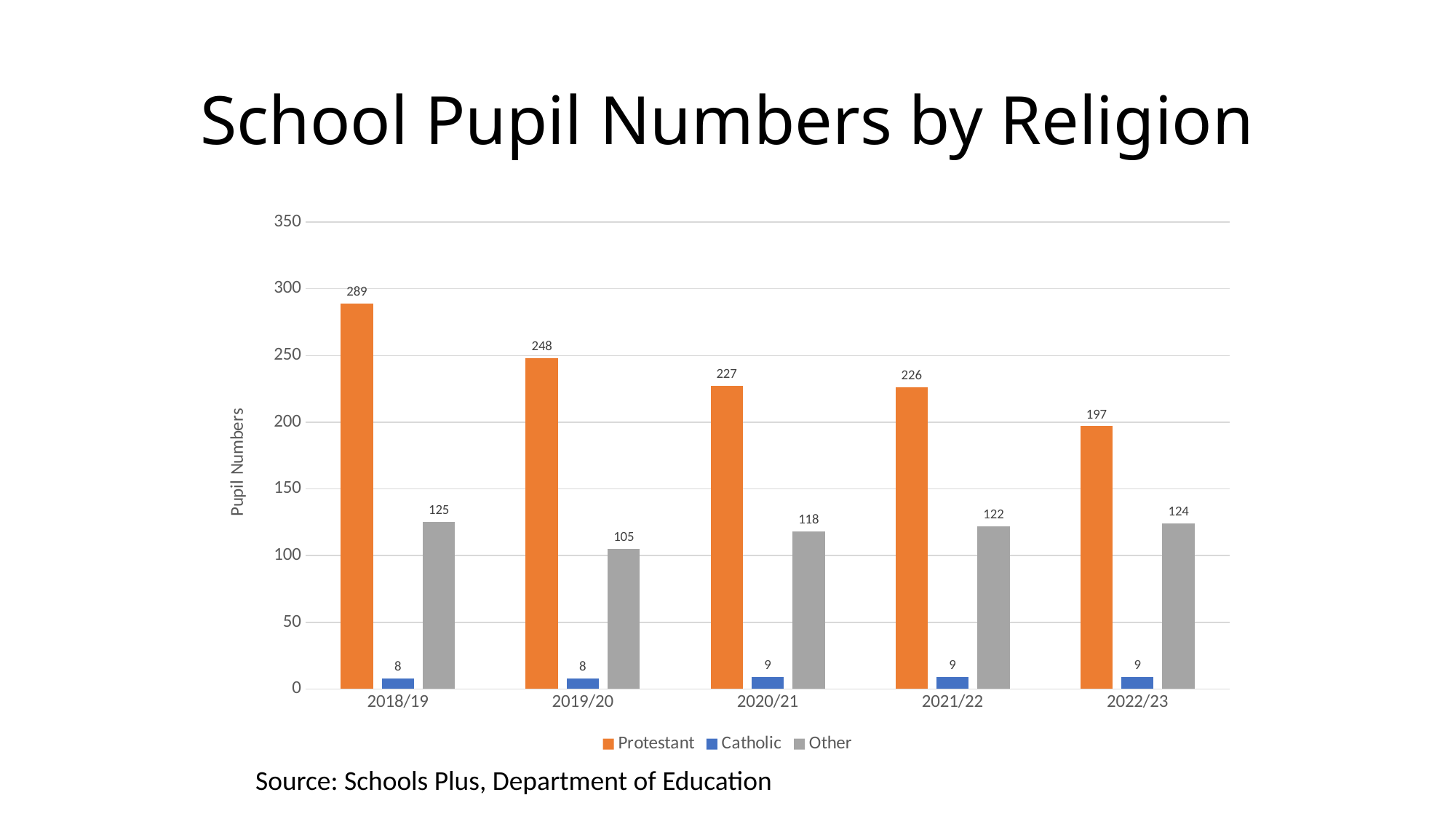
In which year is the Other pupil number lowest? 2019/20 Which is larger, the Other pupil number in 2018/19 or in 2022/23? 2018/19 How many school years are shown on the x axis? 5 What is the Protestant pupil number for 2018/19? 289 What is the difference between the Protestant pupil numbers in 2018/19 and 2022/23? 92 What kind of chart is shown on the slide? bar chart Does the Protestant pupil number rise or fall from 2018/19 to 2022/23? fall How many series does the legend list? 3 In which year is the Protestant pupil number highest? 2018/19 Is the Protestant pupil number for 2022/23 greater or less than 200? less What is the Other pupil number for 2019/20? 105 What is the Catholic pupil number for 2022/23? 9